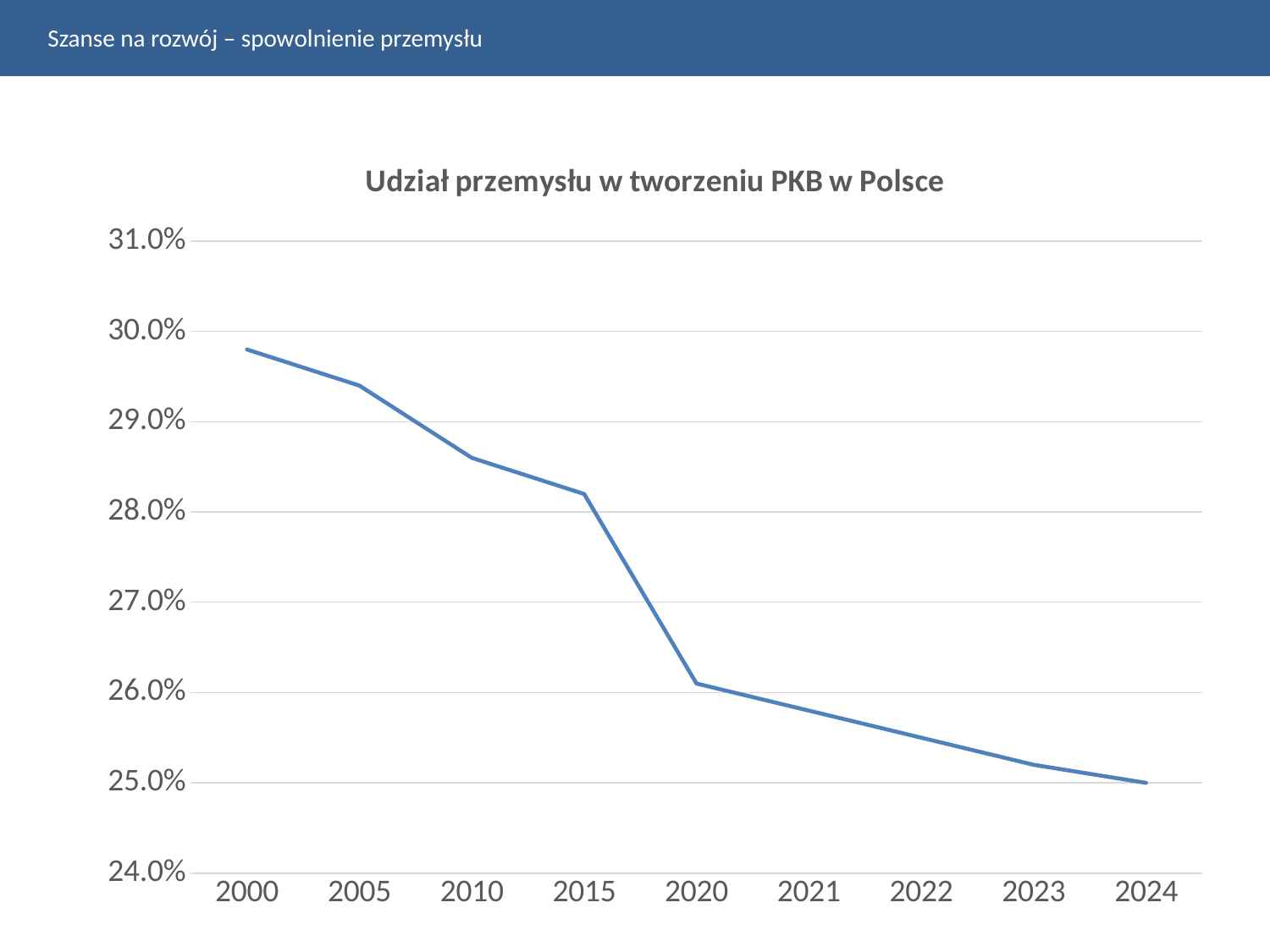
What is the title of the chart? Udział przemysłu w tworzeniu PKB w Polsce What is the value for 2024? 25.0% Which year has the highest value on the chart? 2000 Which is larger, the value for 2005 or the value for 2021? 2005 What kind of chart is shown on the slide? line chart Is the value for 2020 greater or less than 27.0%? less How many years are plotted on the x axis of the chart? 9 Is the value for 2010 greater or less than 29.0%? less Which year has the lowest value on the chart? 2024 Is the value for 2022 greater or less than 26.0%? less Do the values rise or fall from 2000 to 2024? fall